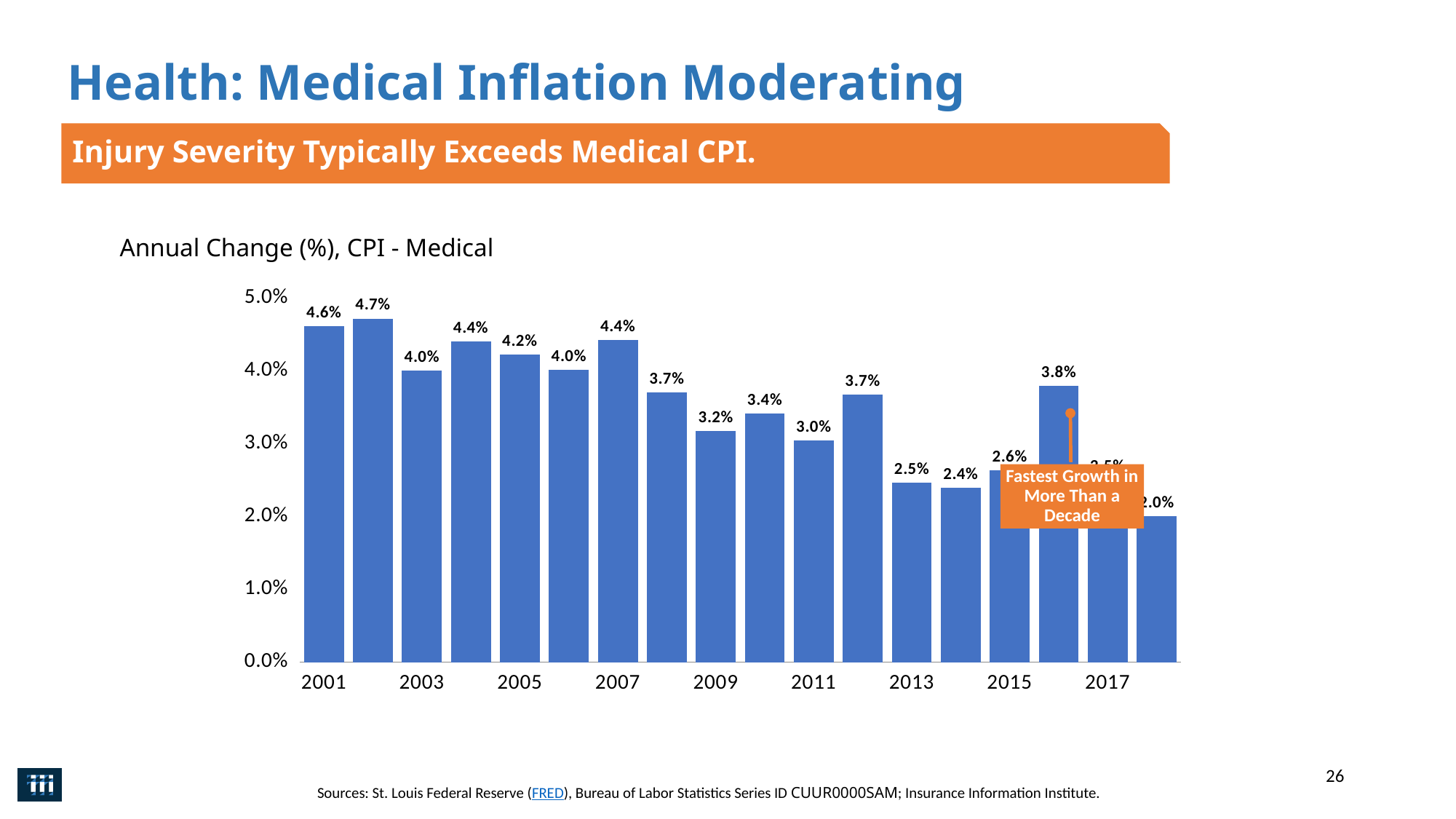
What is the title of the chart? Annual Change (%), CPI - Medical Do the values generally rise or fall from 2001 to the end of the chart? fall What is the annual change in CPI - Medical for 2015? 2.6% What is the annual change in CPI - Medical for 2011? 3.0% Which year has the highest annual change in CPI - Medical? 2002 Which is larger, the annual change for 2005 or for 2009? 2005 What is the difference between the annual change for 2001 and the annual change for 2013? 2.1% What is the annual change in CPI - Medical for 2007? 4.4% What is the annual change in CPI - Medical for 2013? 2.5% What is the annual change in CPI - Medical for 2001? 4.6% What type of chart is shown on the slide? bar chart Is the value for 2013 greater or less than 3.0%? less